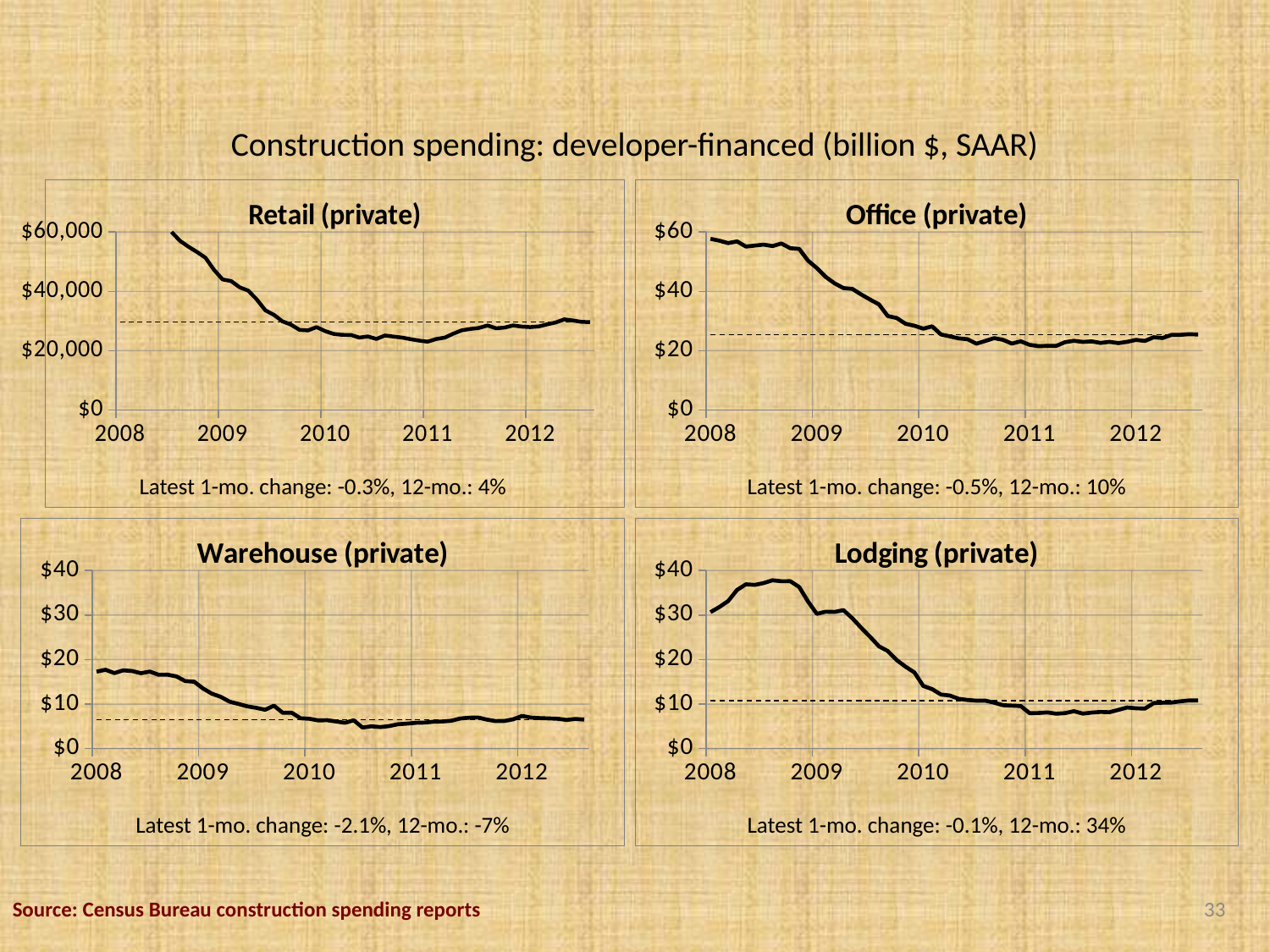
In the Warehouse (private) chart, what is the latest 12-month change? -7% In the Office (private) chart, do values rise or fall between 2008 and 2010? fall In the Lodging (private) chart, is the value at the start of 2011 greater or less than $20? less In the Office (private) chart, what is the latest 1-month change? -0.5% In the Retail (private) chart, what is the latest 12-month change? 4% In the Warehouse (private) chart, is the value at the start of 2008 greater or less than $10? greater In the Lodging (private) chart, what is the latest 12-month change? 34% What kind of chart is the Retail (private) chart? line chart In the Retail (private) chart, is the value at the start of 2011 greater or less than $40,000? less How many charts are shown on the slide? 4 What is the source cited at the bottom of the slide? Census Bureau construction spending reports